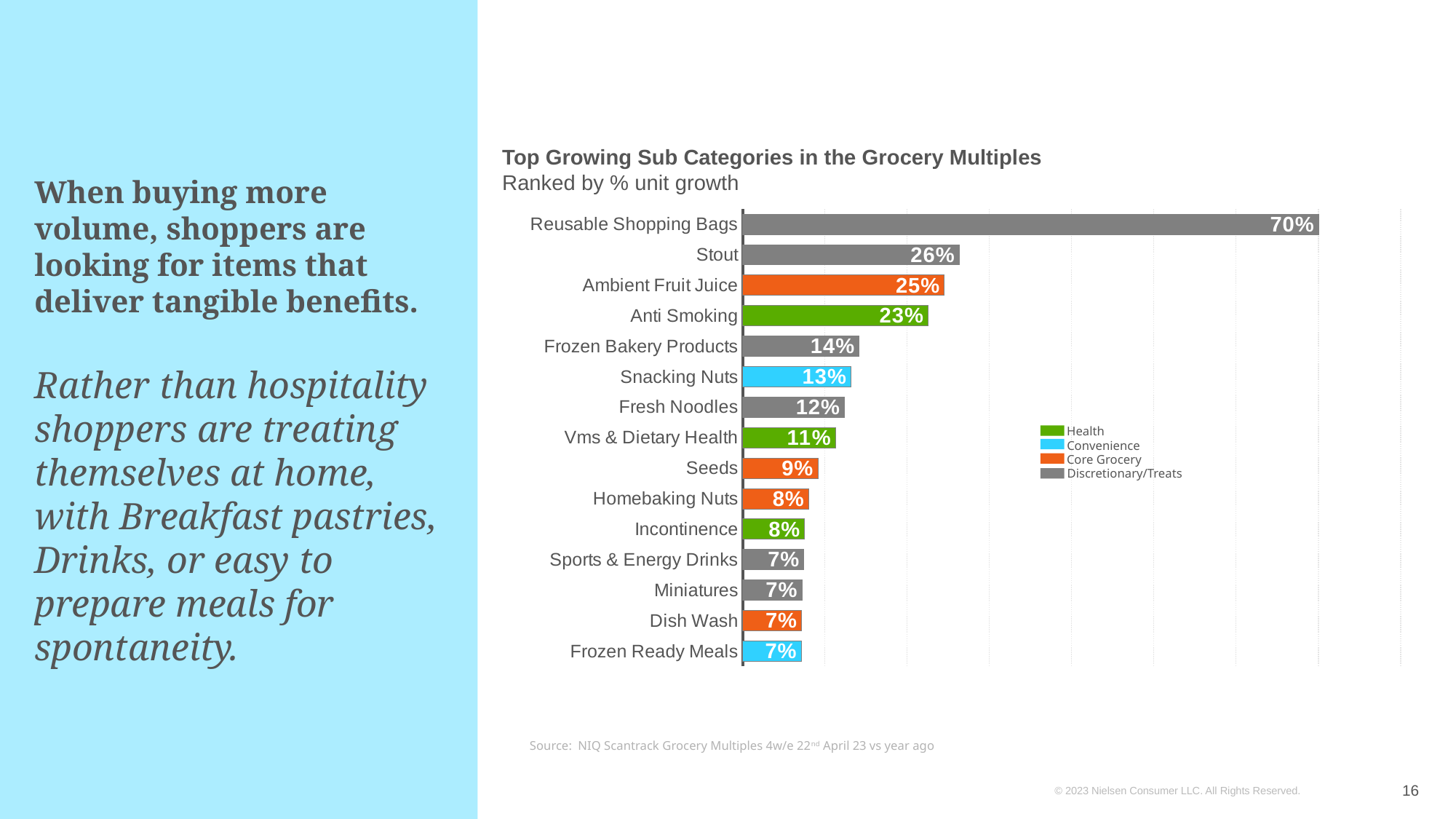
Which has higher % unit growth, Seeds or Incontinence? Seeds What is the difference in % unit growth between Reusable Shopping Bags and Stout? 44% What is the % unit growth for Snacking Nuts? 13% What is the % unit growth for Anti Smoking? 23% What kind of chart is shown on the slide? Bar chart Which legend category does the colour of the Snacking Nuts bar represent? Convenience What is the difference in % unit growth between Stout and Ambient Fruit Juice? 1% Which sub category has the highest % unit growth? Reusable Shopping Bags What is the % unit growth for Reusable Shopping Bags? 70% Which has higher % unit growth, Frozen Bakery Products or Fresh Noodles? Frozen Bakery Products How many sub categories are shown in the chart? 15 How many series does the legend list? 4